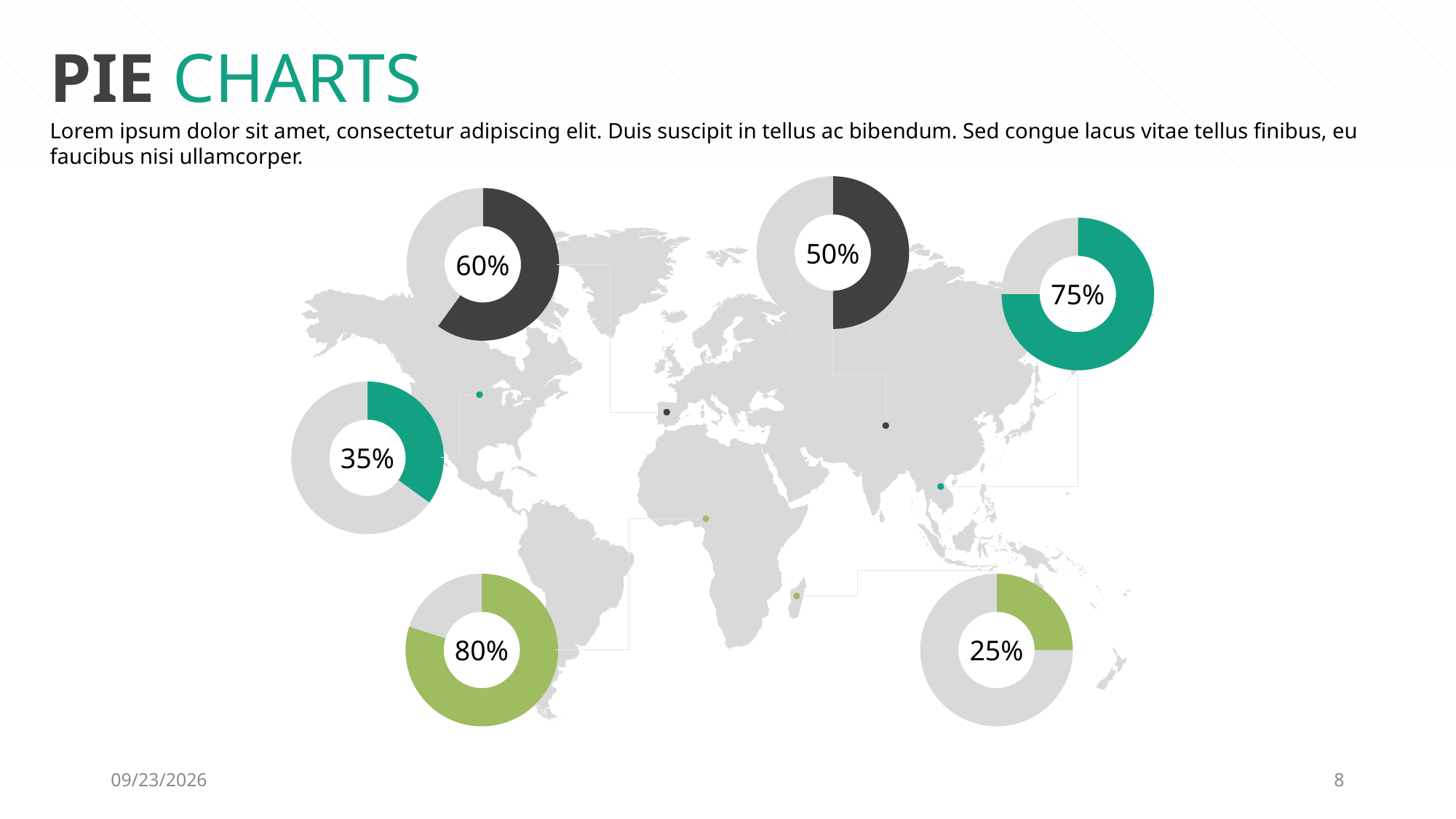
What is the difference between the percentage in the top-right donut chart and the percentage in the bottom-right donut chart? 50% What percentage is shown in the bottom-right donut chart on the slide? 25% What percentage is shown in the top-centre donut chart on the slide? 50% Which donut chart on the slide shows the lowest percentage? The bottom-right chart (25%) What percentage is shown in the top-left donut chart on the slide? 60% Which donut chart on the slide shows the highest percentage? The bottom-left chart (80%) What type of chart is used for the six charts on the slide? Pie (donut) chart What percentage is shown in the top-right donut chart on the slide? 75% How many donut charts are shown on the slide? 6 What percentage is shown in the bottom-left donut chart on the slide? 80% What percentage is shown in the donut chart on the left side of the slide, in the middle row? 35% Which is larger: the percentage in the top-left donut chart or the percentage in the middle-left donut chart? The top-left chart (60%)